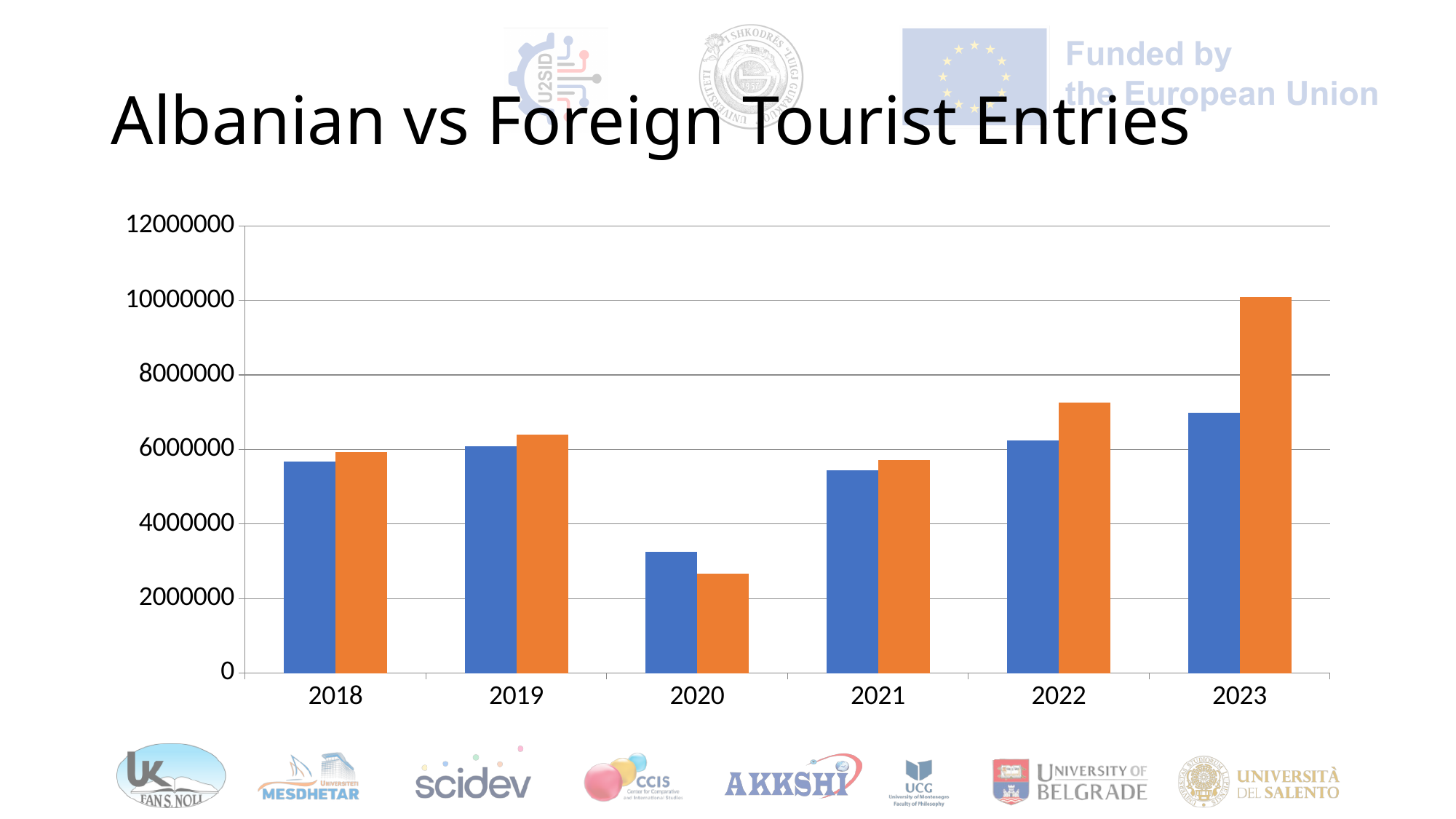
What kind of chart is shown on the slide? Bar chart In 2020, which bar is taller, the blue bar or the orange bar? Blue In which year is the orange bar the highest? 2023 How many bars are plotted for each year in the chart? 2 Is the value of the orange bar for 2023 greater or less than 8000000? greater In which year is the blue bar the lowest? 2020 In which year is the blue bar the highest? 2023 Do the orange bars rise or fall from 2020 to 2023? Rise What is the title of the chart? Albanian vs Foreign Tourist Entries Is the value of the blue bar for 2020 greater or less than 4000000? less How many years are shown on the x axis of the chart? 6 In which year is the orange bar the lowest? 2020